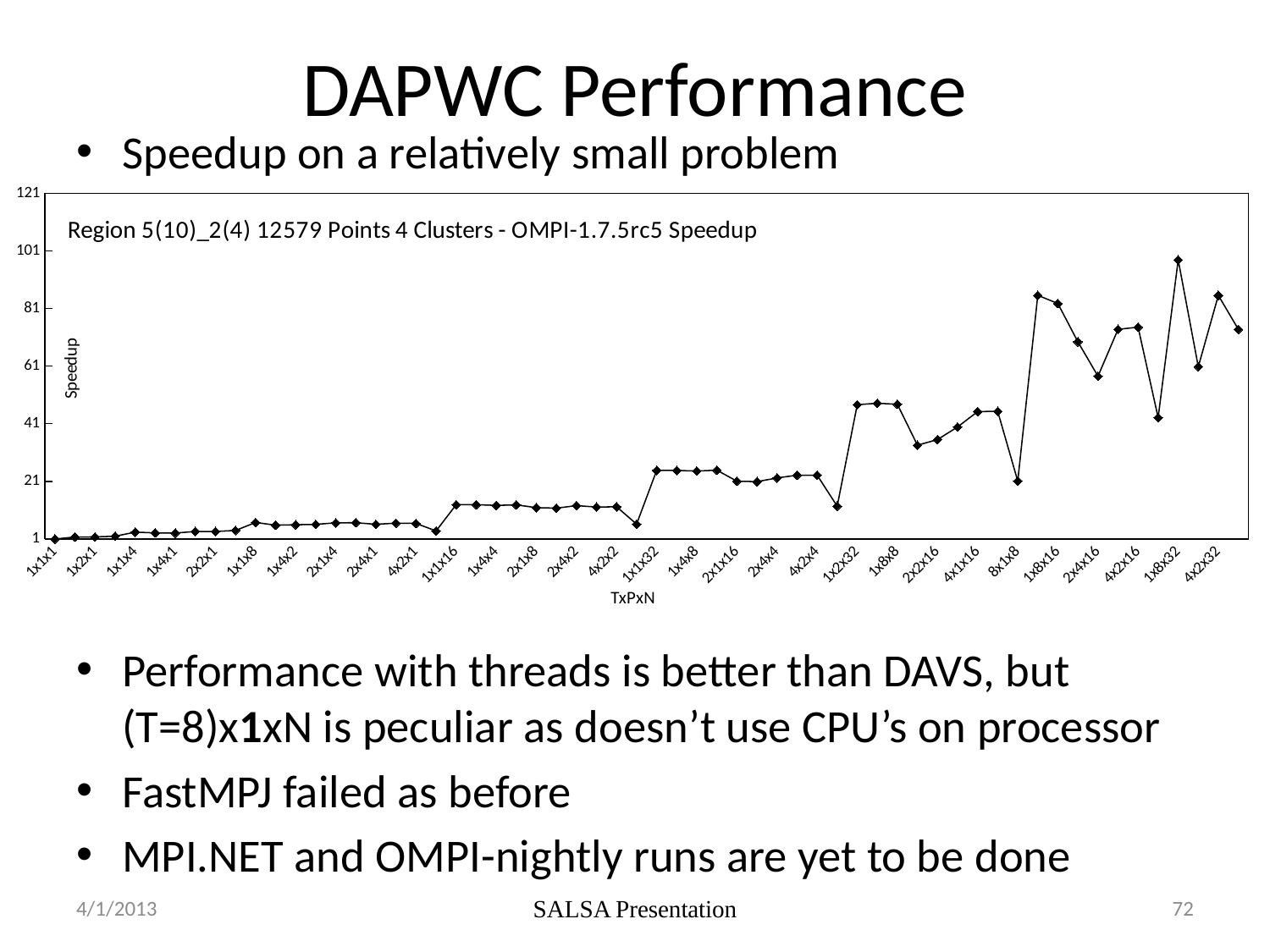
Does the speedup generally rise or fall moving from left to right along the x axis? rise Is the speedup for 1x2x32 greater or less than 41? greater Is the speedup for 1x1x32 greater or less than 21? greater Which has the larger speedup, 1x2x32 or 8x1x8? 1x2x32 What kind of chart is shown on the slide? line chart Is the speedup for 1x8x32 greater or less than 81? greater Which has the larger speedup, 1x8x32 or 4x2x32? 1x8x32 What is the title of the chart? Region 5(10)_2(4) 12579 Points 4 Clusters - OMPI-1.7.5rc5 Speedup What is the label of the x axis of the chart? TxPxN Which TxPxN configuration has the highest speedup? 1x8x32